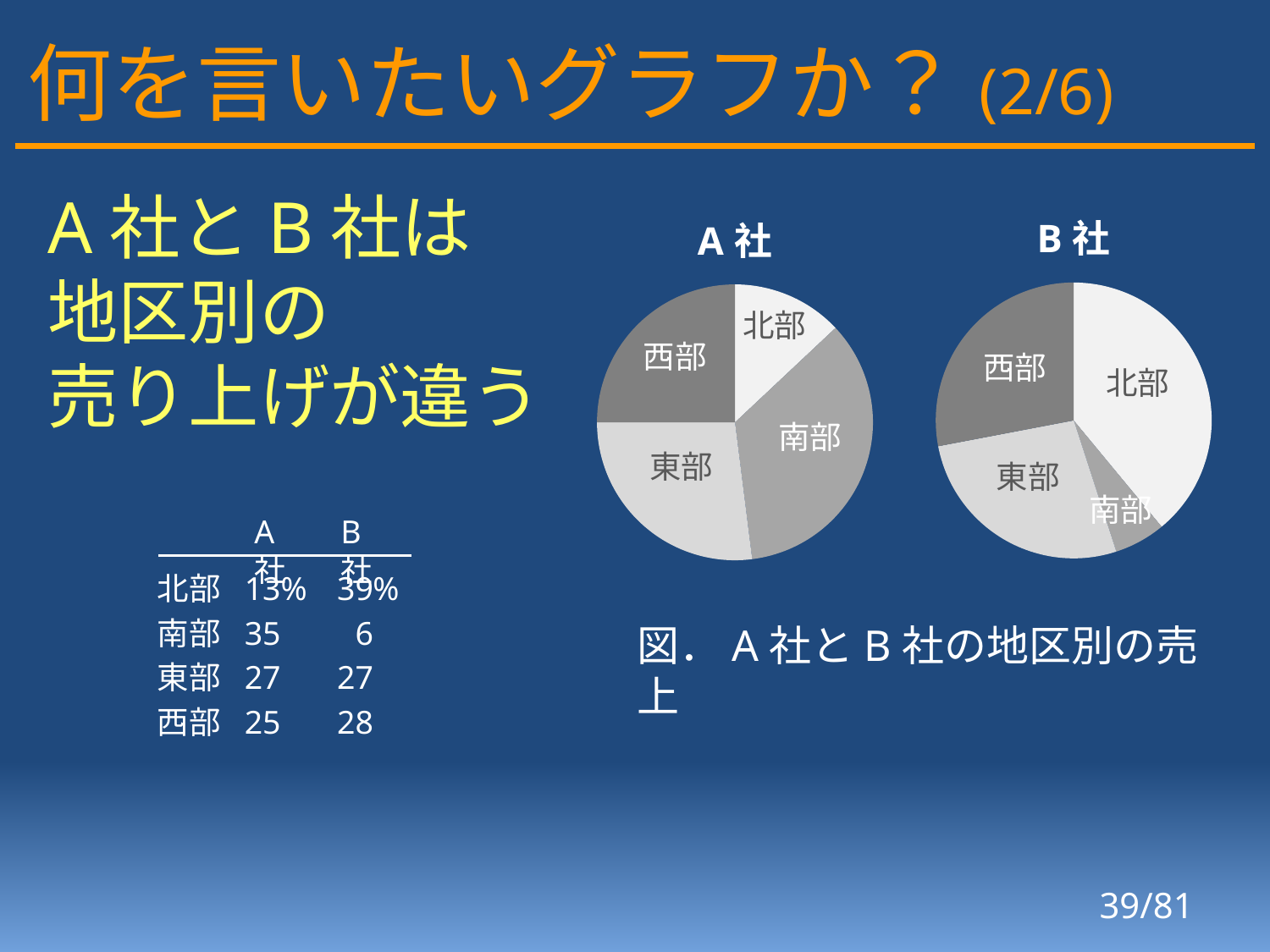
In the B社 pie chart, what share does 北部 have? 39% In the A社 pie chart, which region has the smallest slice? 北部 In the A社 pie chart, which region has the largest slice? 南部 In the B社 pie chart, which region has the largest slice? 北部 In the B社 pie chart, what share does 南部 have? 6% In the B社 pie chart, which slice is larger, 北部 or 西部? 北部 How many slices does the A社 pie chart have? 4 What kind of chart is the A社 chart? pie chart Which company has the larger 南部 share, A社 or B社? A社 What is the difference between the 北部 share of B社 and the 北部 share of A社? 26% In the B社 pie chart, which region has the smallest slice? 南部 In the A社 pie chart, what share does 北部 have? 13%